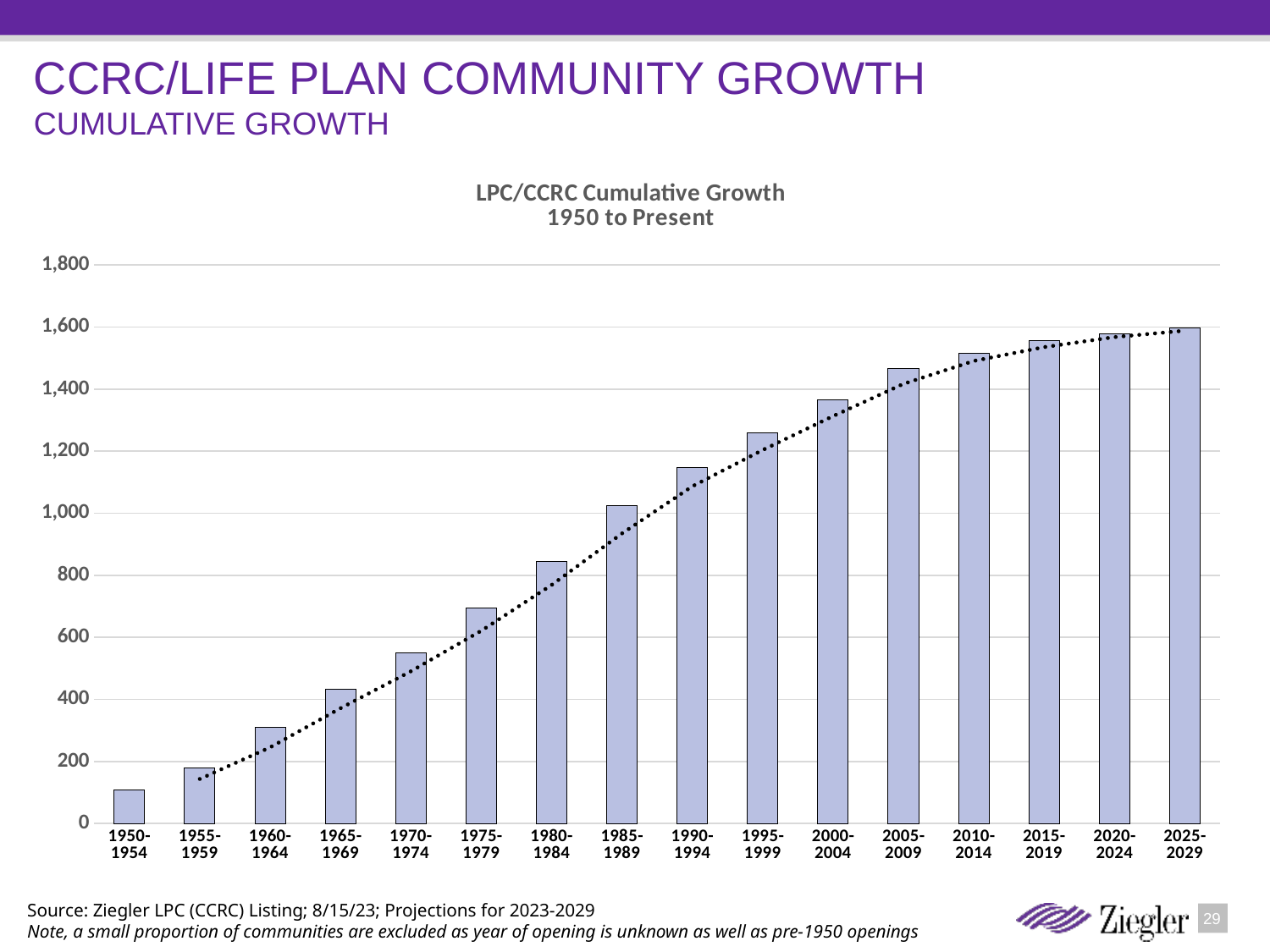
What is the title of the chart? LPC/CCRC Cumulative Growth 1950 to Present What kind of chart is shown on the slide? Bar chart Is the value for 1975-1979 greater or less than 800? less Which is larger, the value for 1980-1984 or the value for 1990-1994? 1990-1994 How many time-period categories are shown on the x axis? 16 Which period has the lowest bar? 1950-1954 Is the value for 2005-2009 greater or less than 1,400? greater Is the value for 1950-1954 greater or less than 200? less Which period has the highest bar? 2025-2029 Do the bar values rise or fall from left to right along the x axis? Rise